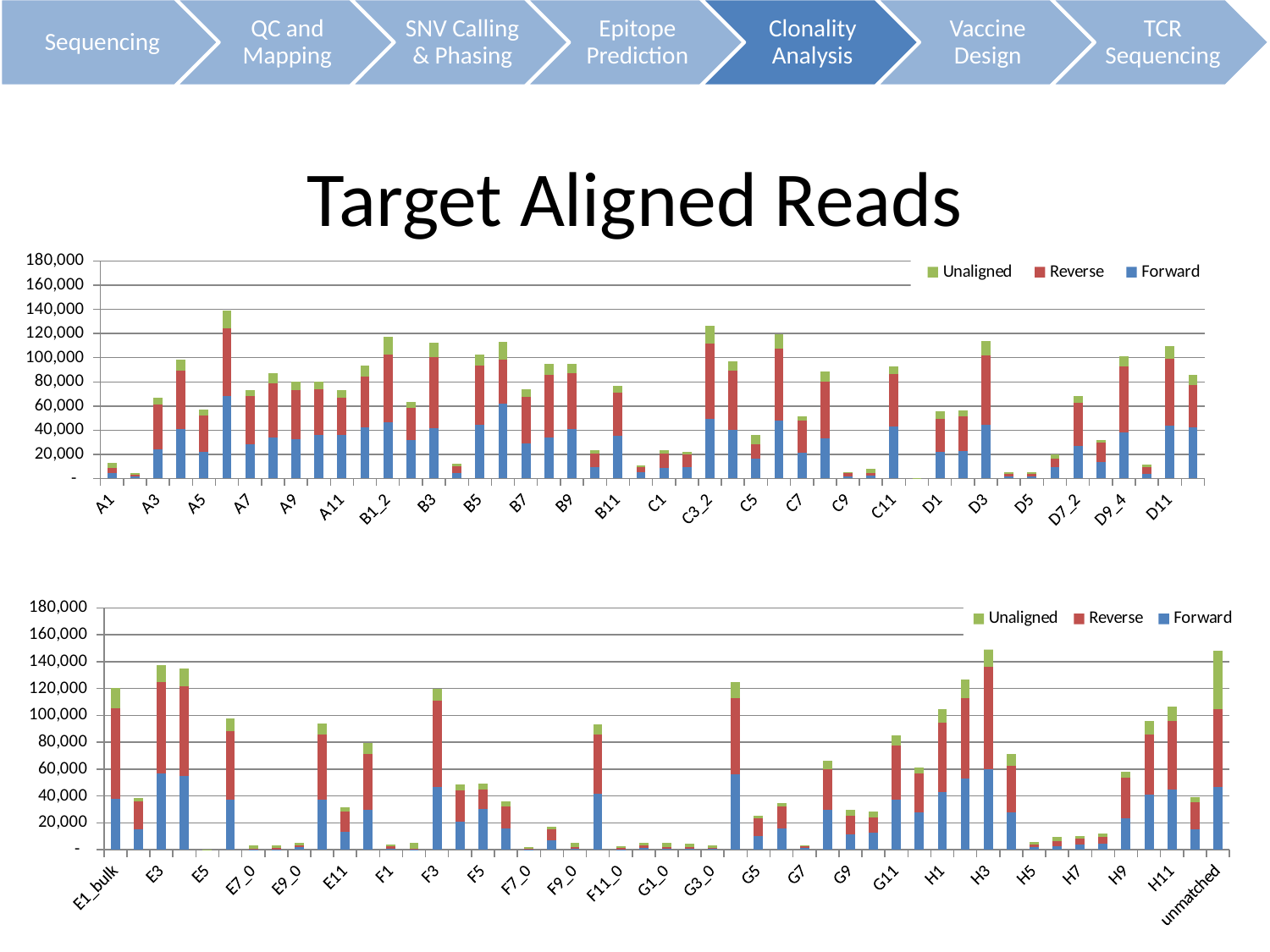
In the top chart, is the total value for D3 greater or less than 100,000? greater In the bottom chart, is the total value for E1_bulk greater or less than 100,000? greater In the top chart, which has the larger total, D3 or D5? D3 In the bottom chart, is the total value for H5 greater or less than 20,000? less What are the series names in the legend of the bottom chart? Unaligned, Reverse, Forward What kind of chart is the top chart on the slide? Stacked bar chart How many series does the legend of the top chart list? 3 In the bottom chart, which has the larger total, E3 or E5? E3 In the top chart, which series is shown in green? Unaligned